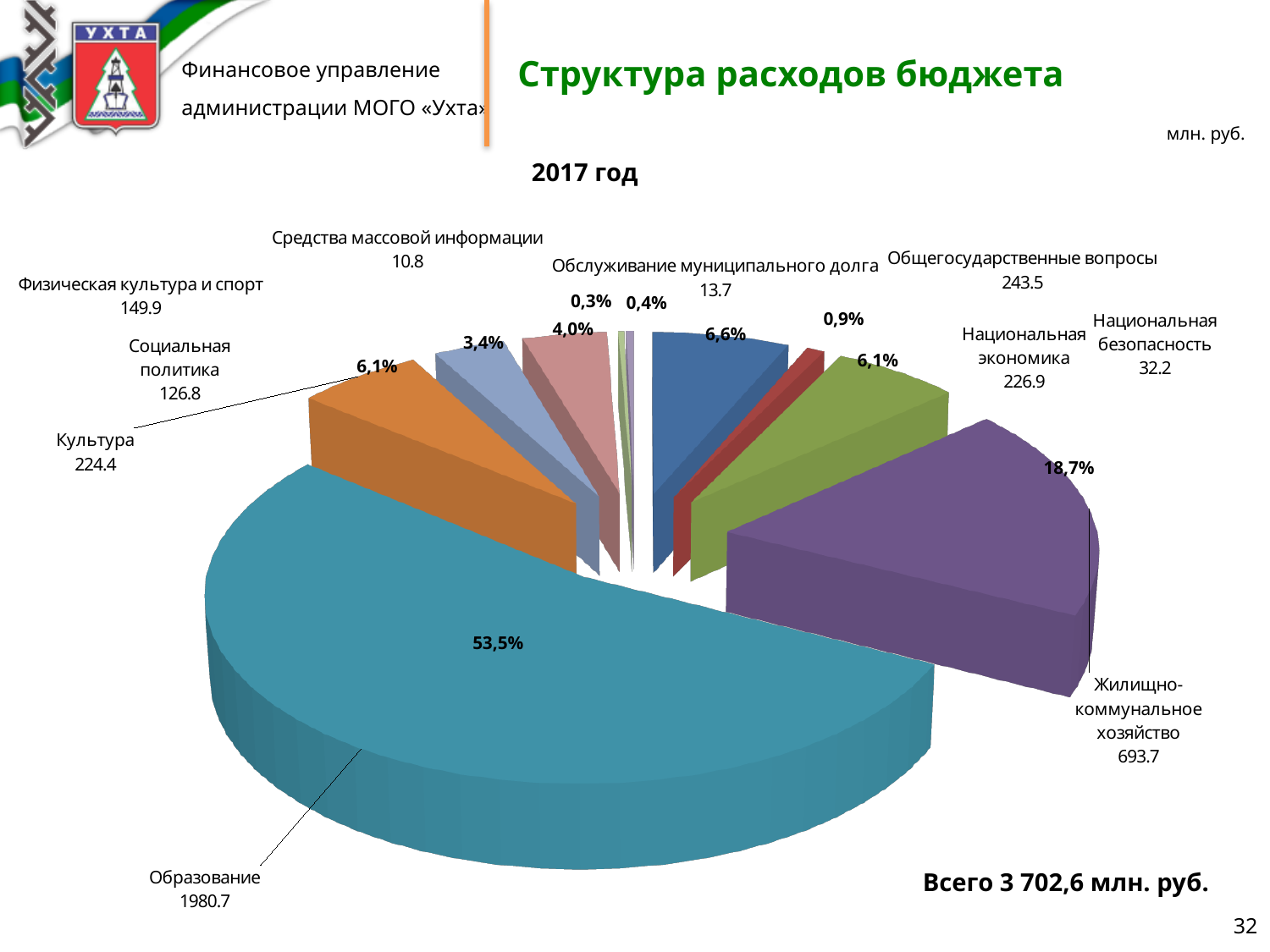
What is the value for Жилищно-коммунальное хозяйство? 693.7 Which category has the largest value? Образование What kind of chart is shown on the slide? pie chart Which category has the smallest value? Средства массовой информации What is the value for Национальная безопасность? 32.2 What is the value for Культура? 224.4 What is the value for Образование? 1980.7 What total is stated for the budget expenditures on the slide? 3 702,6 млн. руб. Which is larger, Физическая культура и спорт or Социальная политика? Физическая культура и спорт How many categories does the pie chart show? 10 What share of the pie does Образование represent? 53,5% What is the difference between Общегосударственные вопросы and Национальная экономика? 16.6